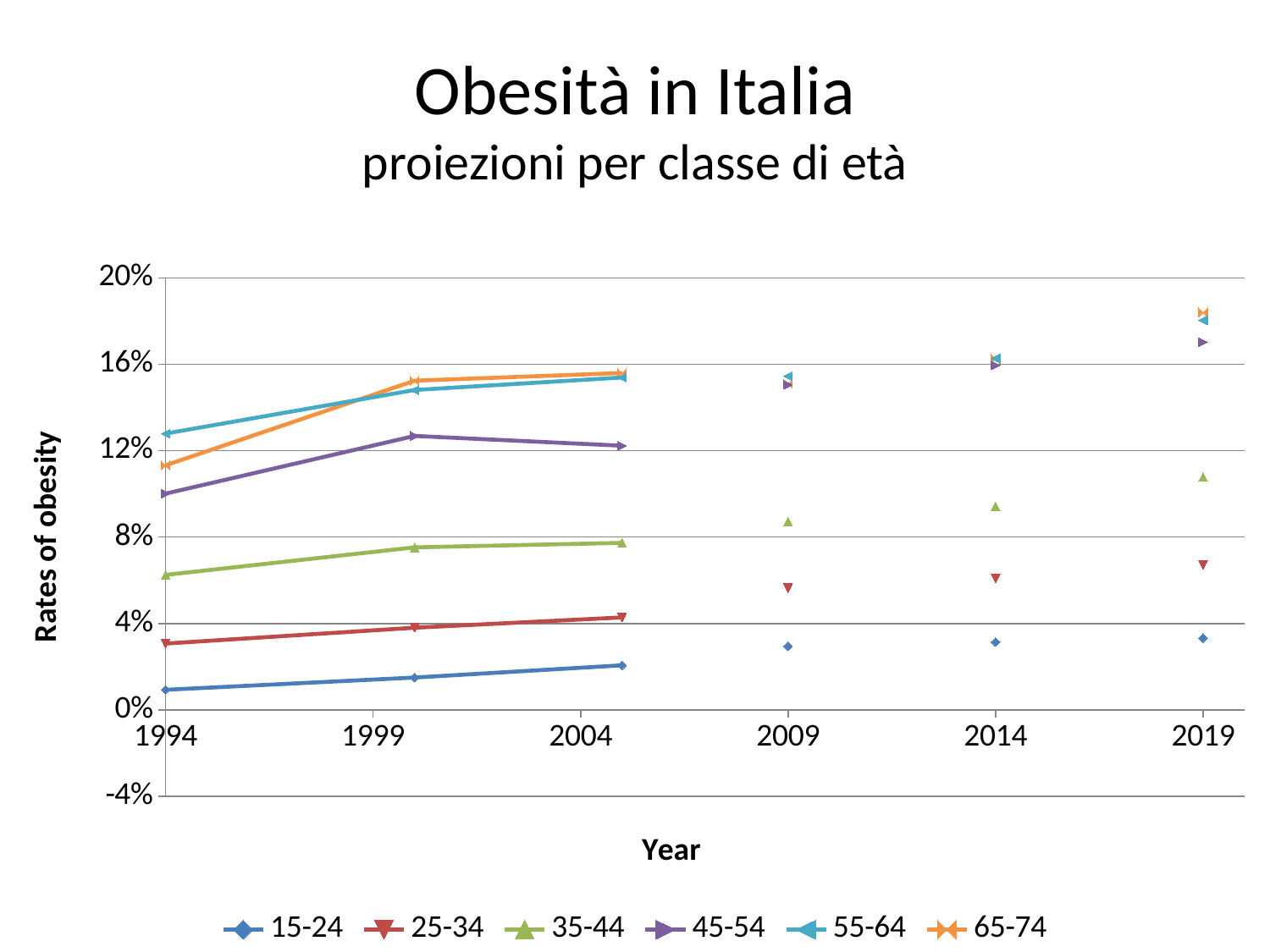
Is the value for the 25-34 series in 2014 greater or less than 8%? less In 2009, which is larger: the value for 45-54 or the value for 35-44? 45-54 What kind of chart is shown on the slide? line chart Which series has the lowest value in 2019? 15-24 Does the 15-24 series rise or fall from 1994 to 2004? rise Is the value for the 65-74 series in 2019 greater or less than 16%? greater How many years are marked on the x axis? 6 Is the value for the 35-44 series in 2019 greater or less than 8%? greater What is the main title of the chart on the slide? Obesità in Italia What is the label of the vertical axis? Rates of obesity How many series does the legend list? 6